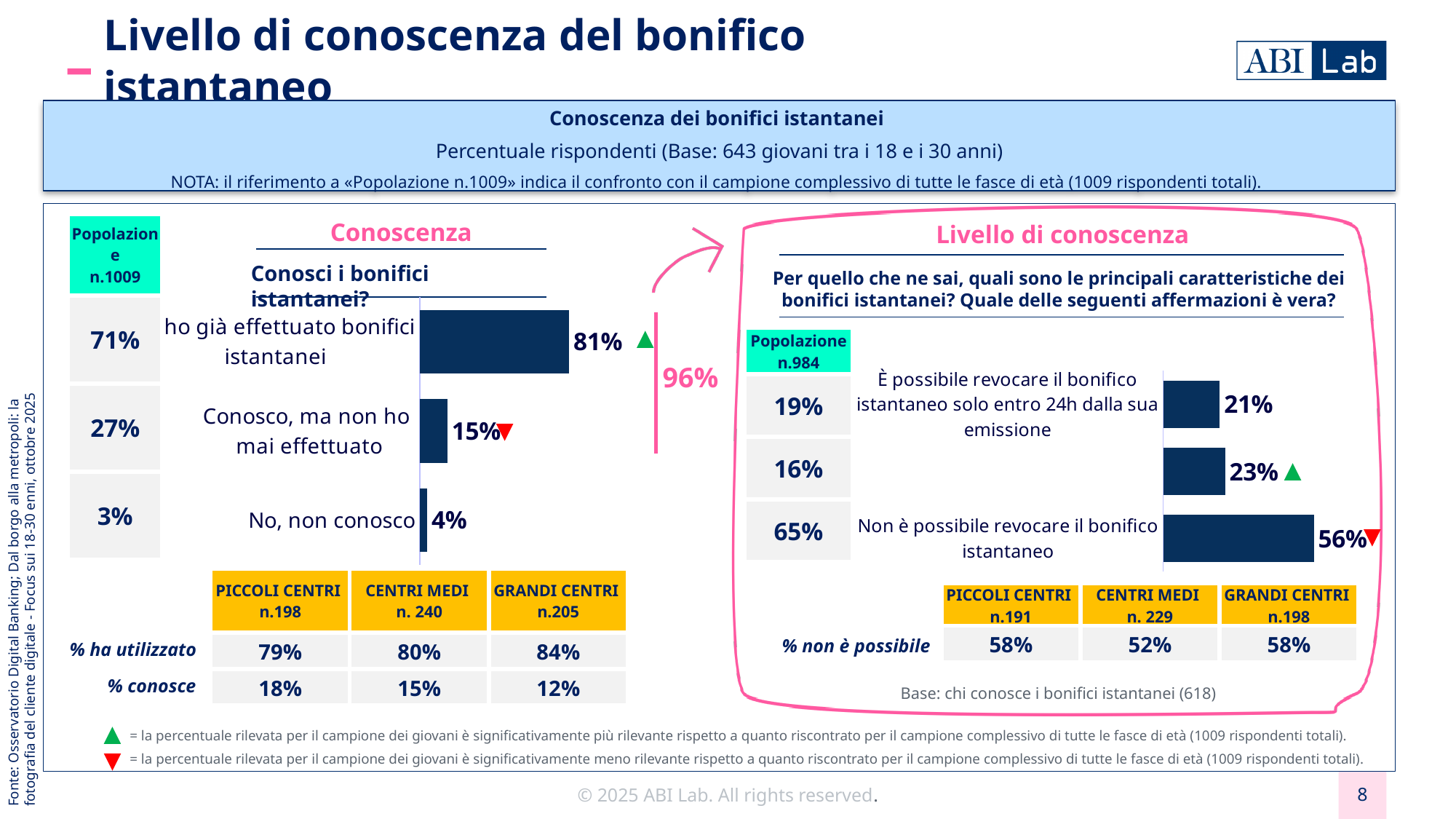
In the 'Conoscenza' chart, which category has the lowest value? No, non conosco How many categories are plotted in the 'Conoscenza' chart? 3 What kind of chart is the 'Conoscenza' chart? Bar chart In the 'Conoscenza' chart, what is the difference between 'ho già effettuato bonifici istantanei' and 'Conosco, ma non ho mai effettuato'? 66% In the 'Livello di conoscenza' chart, what is the value for 'Non è possibile revocare il bonifico istantaneo'? 56% In the 'Livello di conoscenza' chart, what is the difference between 'Non è possibile revocare il bonifico istantaneo' and 'È possibile revocare il bonifico istantaneo solo entro 24h dalla sua emissione'? 35% In the 'Livello di conoscenza' chart, which category has the highest value? Non è possibile revocare il bonifico istantaneo In the 'Conoscenza' chart, what percentage of respondents answered 'ho già effettuato bonifici istantanei'? 81% In the 'Conoscenza' chart, which category has the highest value? ho già effettuato bonifici istantanei In the 'Conoscenza' chart, what is the value for 'Conosco, ma non ho mai effettuato'? 15% In the 'Livello di conoscenza' chart, what is the value for 'È possibile revocare il bonifico istantaneo solo entro 24h dalla sua emissione'? 21% In the 'Conoscenza' chart, what is the value for 'No, non conosco'? 4%